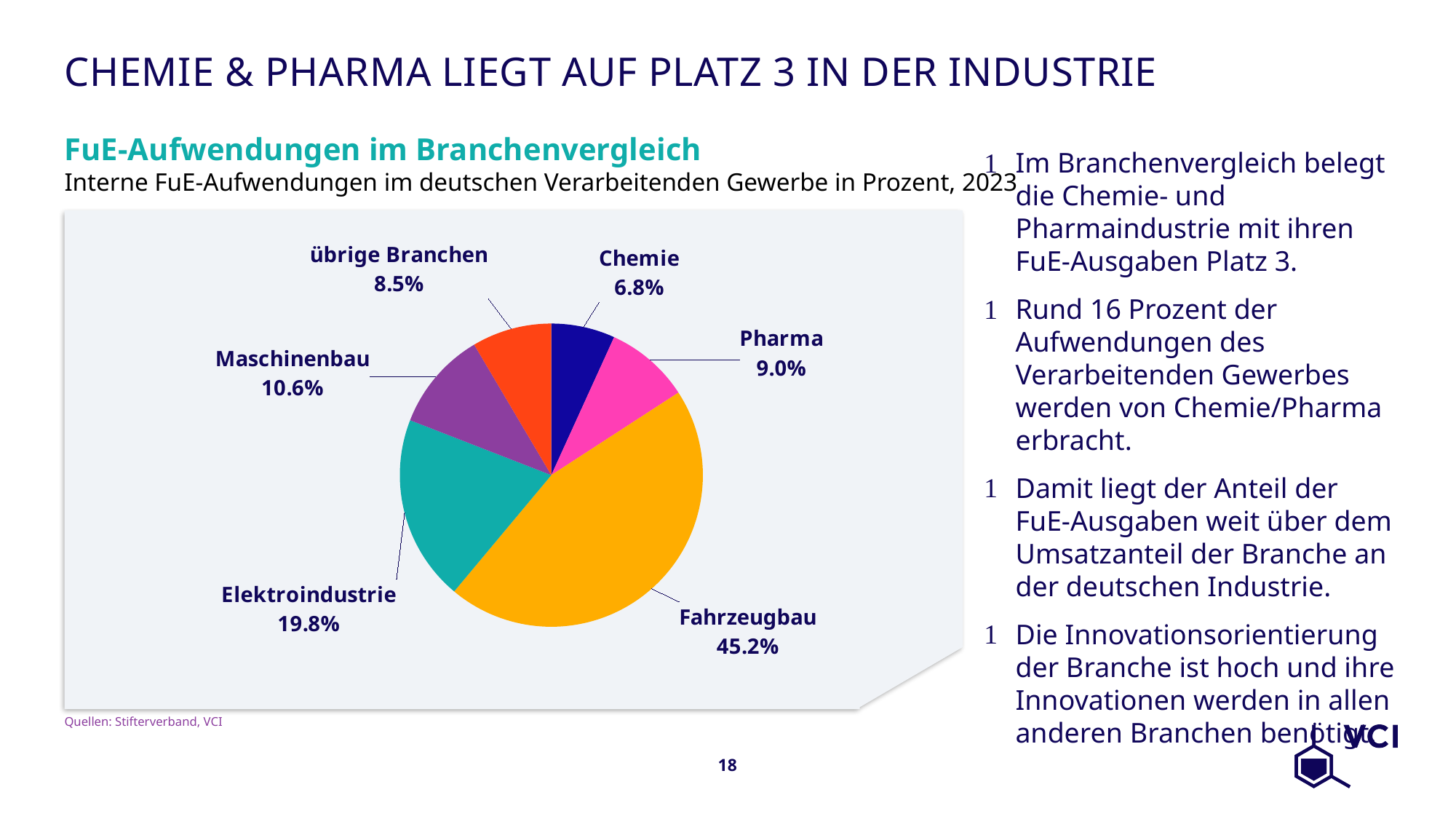
What is the value shown for Elektroindustrie? 19.8% What is the difference between the shares of Fahrzeugbau and Elektroindustrie? 25.4 percentage points Which is larger, the share of Maschinenbau or the share of übrige Branchen? Maschinenbau What is the value shown for Pharma? 9.0% What share of internal R&D expenditure does Fahrzeugbau account for? 45.2% What is the value shown for Chemie? 6.8% Which sector has the smallest slice of the pie? Chemie Which sector has the largest slice of the pie? Fahrzeugbau How many sectors are shown in the pie chart? 6 What kind of chart is shown on the slide? pie chart What is the title of the chart? FuE-Aufwendungen im Branchenvergleich What is the combined share of Chemie and Pharma? 15.8%